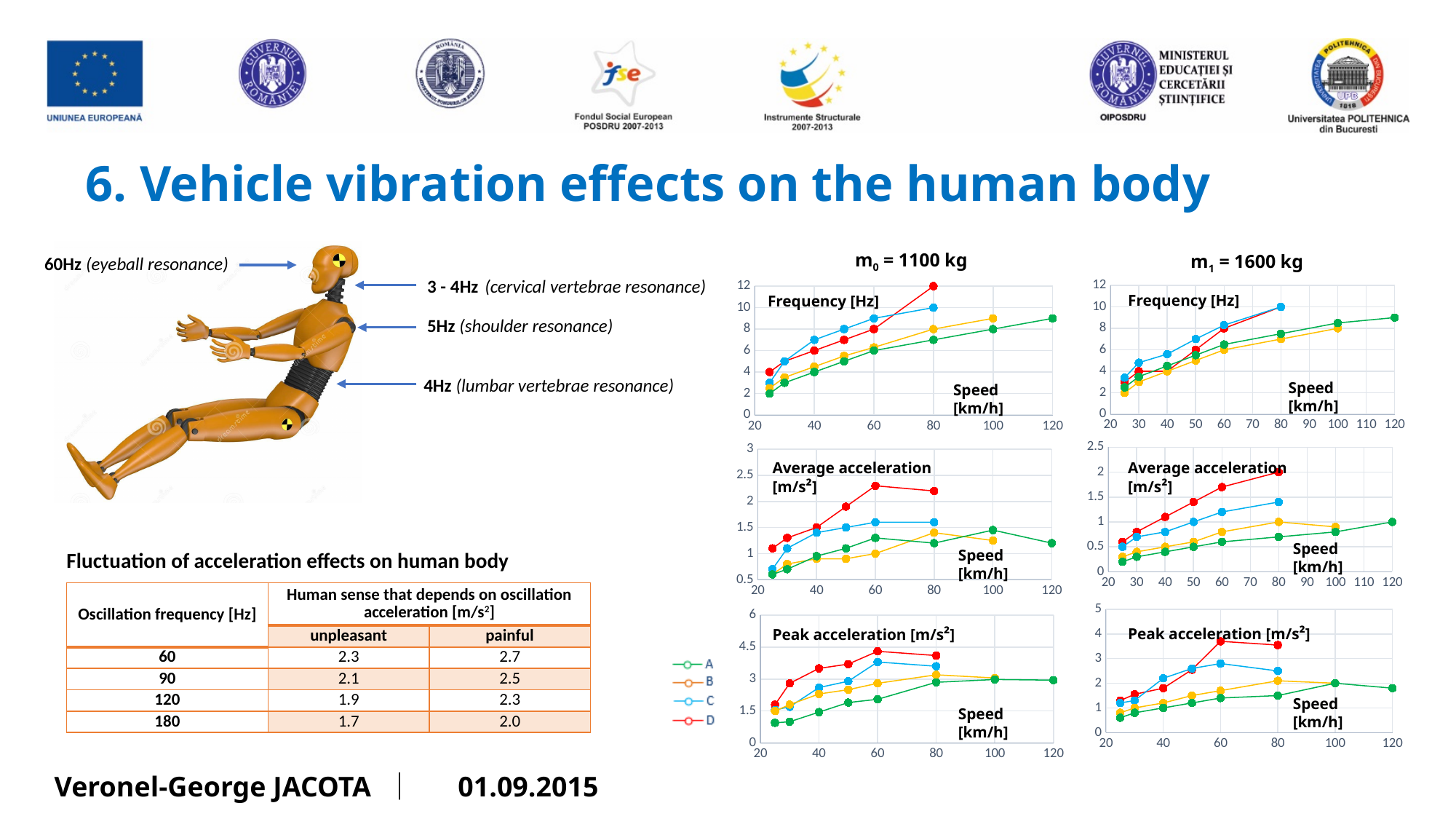
In the m0 = 1100 kg 'Frequency [Hz]' chart, which series has the lowest value at 80 km/h? A What kind of chart is the 'Frequency [Hz]' chart under m0 = 1100 kg? line chart In the m1 = 1600 kg 'Peak acceleration [m/s²]' chart, which series has the highest value at 60 km/h? D In the m0 = 1100 kg 'Average acceleration [m/s²]' chart, which is larger at 60 km/h, series D or series A? series D In the m0 = 1100 kg 'Peak acceleration [m/s²]' chart, is the value for series D at 60 km/h greater or less than 3? greater In the m1 = 1600 kg 'Frequency [Hz]' chart, is the value for series A at 120 km/h greater or less than 8? greater In the m1 = 1600 kg 'Average acceleration [m/s²]' chart, is the value for series D at 80 km/h greater or less than 1.5? greater In the m0 = 1100 kg 'Frequency [Hz]' chart, do the values for series A rise or fall as speed increases? rise How many series does the legend list for the charts on the right of the slide? 4 In the m0 = 1100 kg 'Peak acceleration [m/s²]' chart, which is larger at 25 km/h, series D or series A? series D What colour is series D in the chart legend? red